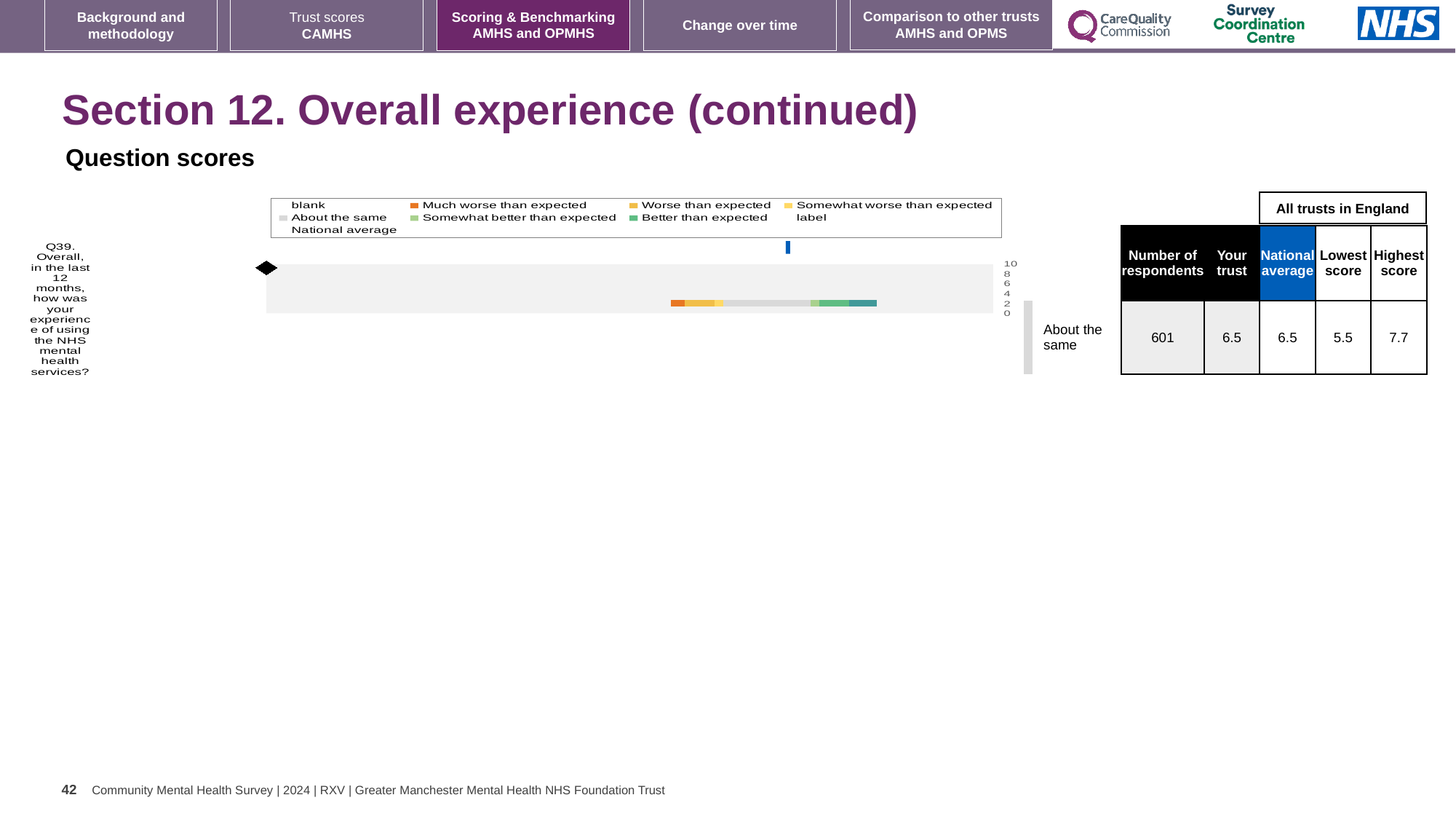
Which question is plotted on the chart? Q39. Overall, in the last 12 months, how was your experience of using the NHS mental health services? What kind of chart is used to show the Q39 question score? bar chart What is the highest score among all trusts in England for Q39? 7.7 What is the difference between the highest and lowest trust scores for Q39? 2.2 What is the national average score for Q39? 6.5 Is the trust's score for Q39 higher than, lower than, or the same as the national average? the same What is the trust's score for Q39? 6.5 What is the lowest score among all trusts in England for Q39? 5.5 How many respondents answered Q39? 601 How many questions are plotted on the chart? 1 Which benchmark category does the trust's Q39 score fall into? About the same